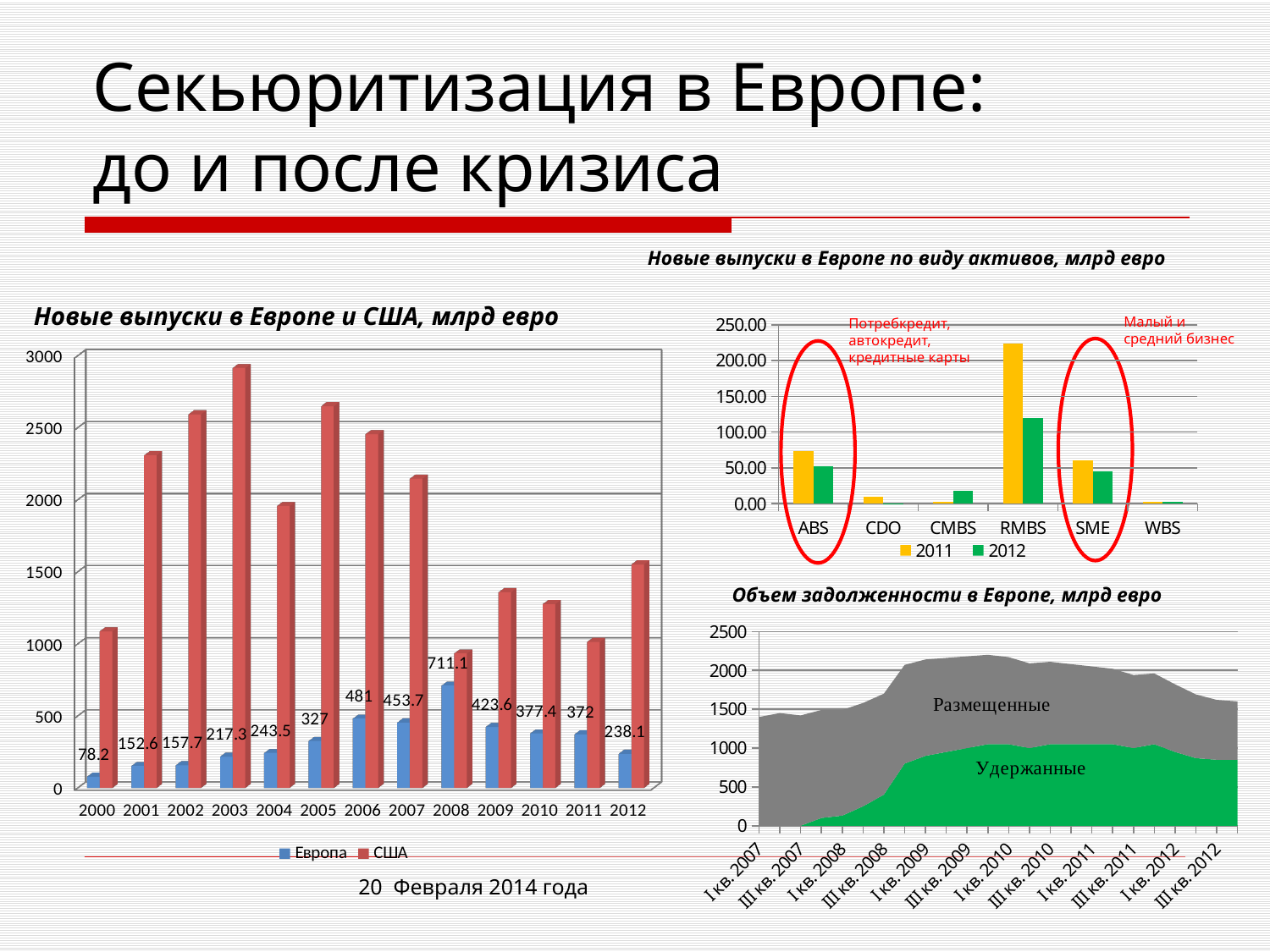
In the chart 'Новые выпуски в Европе и США, млрд евро', is the value for США in 2003 greater or less than 2500? greater In the chart 'Новые выпуски в Европе по виду активов, млрд евро', which asset type has the highest value for 2011? RMBS In the chart 'Новые выпуски в Европе и США, млрд евро', what is the difference between the Европа values for 2008 and 2007? 257.4 How many years are shown on the x axis of the chart 'Новые выпуски в Европе и США, млрд евро'? 13 In the chart 'Новые выпуски в Европе и США, млрд евро', is the Европа value larger in 2006 or in 2007? 2006 In the chart 'Новые выпуски в Европе и США, млрд евро', which year has the highest value for Европа? 2008 In the chart 'Новые выпуски в Европе и США, млрд евро', what is the value for Европа in 2008? 711.1 What kind of chart is 'Объем задолженности в Европе, млрд евро'? area chart In the chart 'Новые выпуски в Европе по виду активов, млрд евро', is the 2011 value for RMBS greater or less than 200.00? greater In the chart 'Новые выпуски в Европе и США, млрд евро', what is the value for Европа in 2000? 78.2 In the chart 'Новые выпуски в Европе и США, млрд евро', which year has the lowest value for Европа? 2000 In the chart 'Новые выпуски в Европе и США, млрд евро', do the Европа values rise or fall from 2008 to 2012? fall